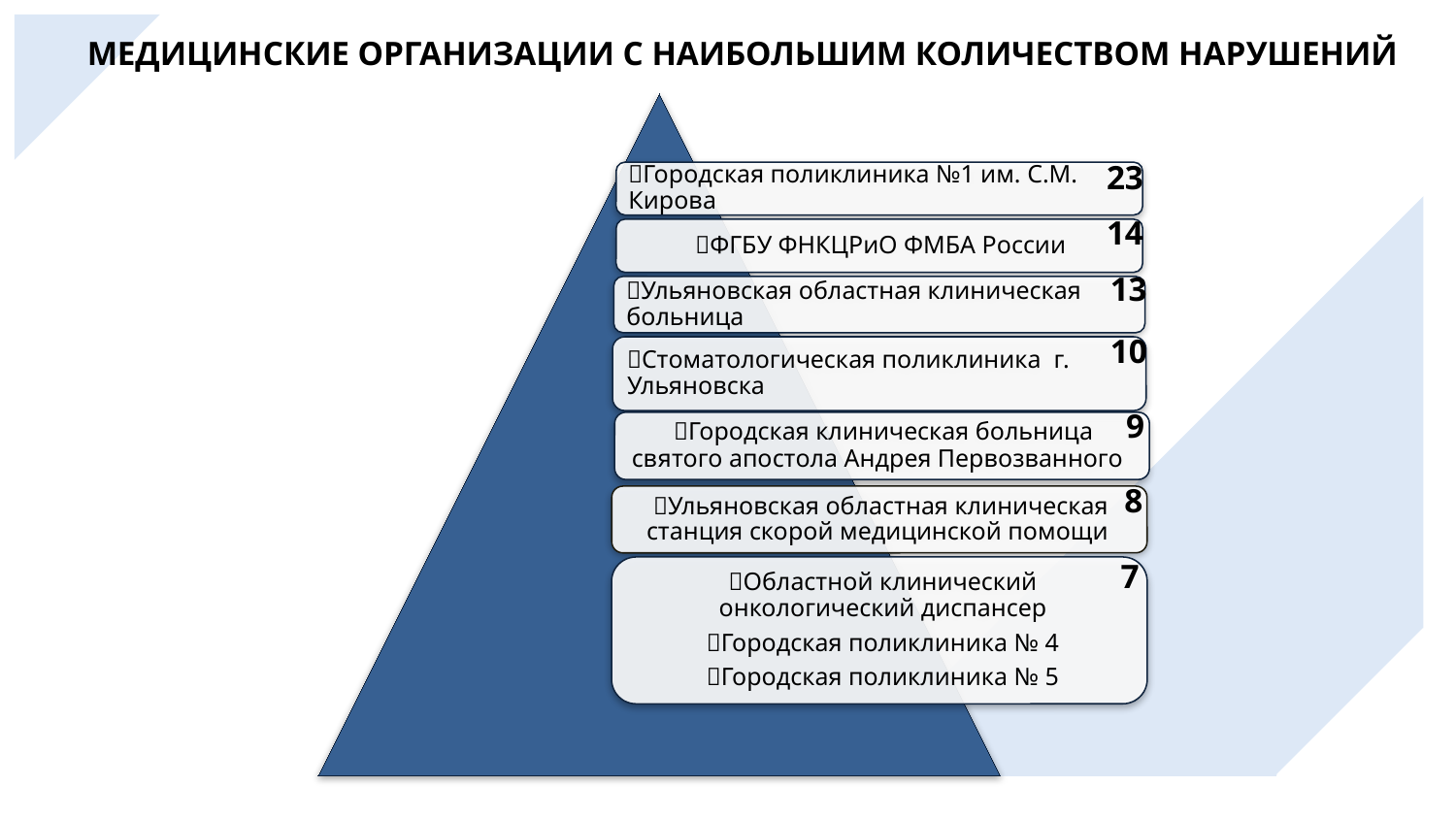
What is the difference between the values for Городская поликлиника №1 им. С.М. Кирова and ФГБУ ФНКЦРиО ФМБА России? 9 What is the lowest value shown in the pyramid? 7 What value is shown for ФГБУ ФНКЦРиО ФМБА России? 14 Which organization has the highest number of violations? Городская поликлиника №1 им. С.М. Кирова How many levels does the pyramid have? 7 What kind of diagram is shown on the slide? Pyramid diagram Do the values increase or decrease from the top of the pyramid to the bottom? Decrease How many violations are shown for Городская поликлиника №1 им. С.М. Кирова? 23 What value is shown for Ульяновская областная клиническая больница? 13 What value is shown for Стоматологическая поликлиника г. Ульяновска? 10 What value is shown for Ульяновская областная клиническая станция скорой медицинской помощи? 8 Which has more violations: Ульяновская областная клиническая больница or Стоматологическая поликлиника г. Ульяновска? Ульяновская областная клиническая больница